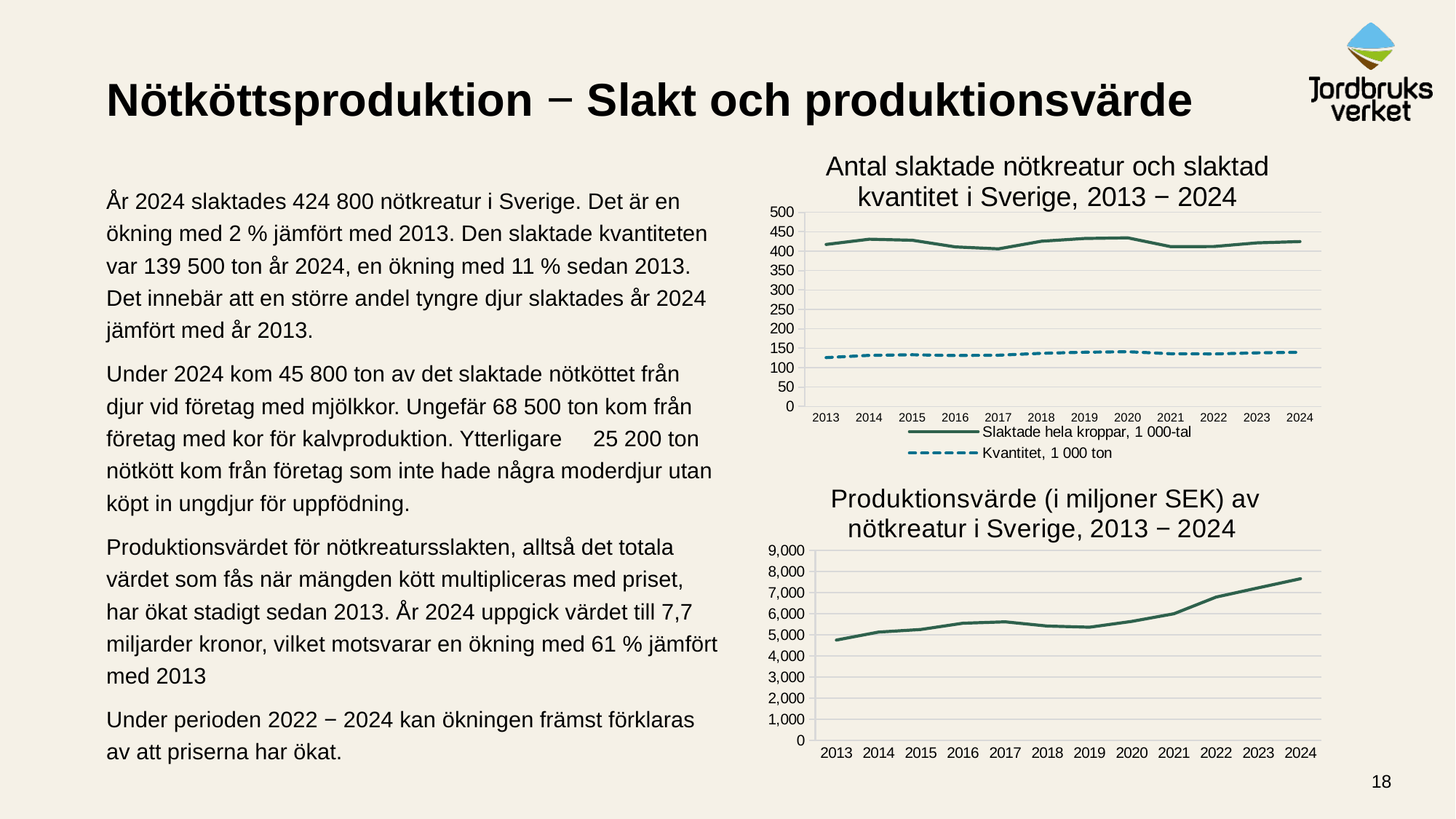
In the top chart (Antal slaktade nötkreatur och slaktad kvantitet), which series is drawn with a dashed line? Kvantitet, 1 000 ton In the bottom chart (Produktionsvärde av nötkreatur), do the values generally rise or fall from 2013 to 2024? rise In the top chart (Antal slaktade nötkreatur och slaktad kvantitet), how many years are shown on the x axis? 12 In the top chart (Antal slaktade nötkreatur och slaktad kvantitet), which series has the larger value in 2020: "Slaktade hela kroppar, 1 000-tal" or "Kvantitet, 1 000 ton"? Slaktade hela kroppar, 1 000-tal In the top chart (Antal slaktade nötkreatur och slaktad kvantitet), is the value for "Slaktade hela kroppar, 1 000-tal" in 2013 greater or less than 400? greater In the bottom chart (Produktionsvärde av nötkreatur), is the value for 2024 greater or less than 7,000? greater What kind of chart is the top chart titled "Antal slaktade nötkreatur och slaktad kvantitet i Sverige, 2013 − 2024"? line chart In the bottom chart (Produktionsvärde av nötkreatur), which year has the highest value? 2024 In the top chart (Antal slaktade nötkreatur och slaktad kvantitet), is the value for "Kvantitet, 1 000 ton" in 2013 greater or less than 150? less What kind of chart is the bottom chart titled "Produktionsvärde (i miljoner SEK) av nötkreatur i Sverige, 2013 − 2024"? line chart In the bottom chart (Produktionsvärde av nötkreatur), which year has the lowest value? 2013 How many series does the legend of the top chart (Antal slaktade nötkreatur och slaktad kvantitet) list? 2